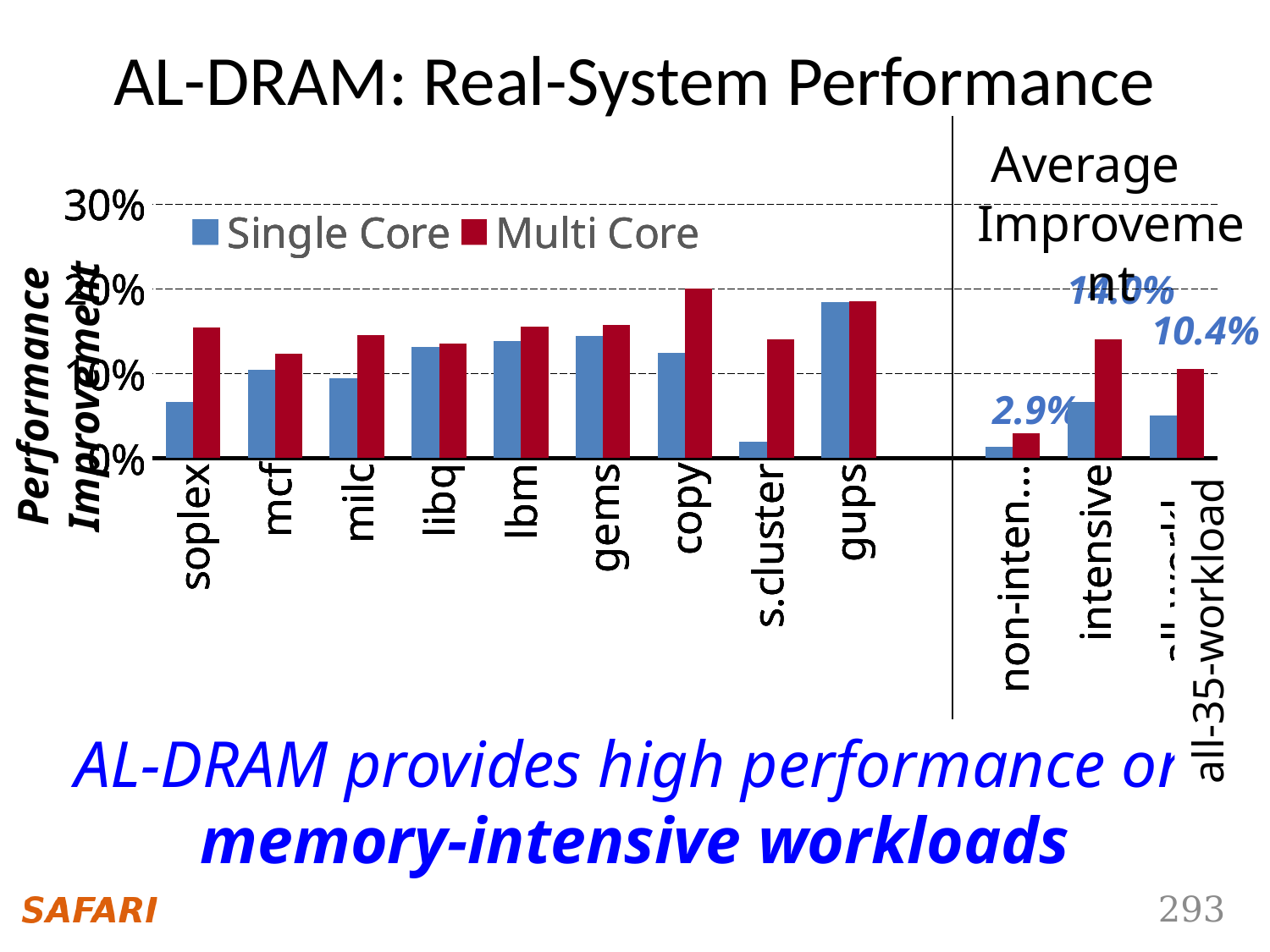
What kind of chart is shown on the slide? bar chart What is the labelled average Multi Core improvement for the intensive workloads? 14.0% Which benchmark has the highest Single Core performance improvement? gups Which benchmark has the highest Multi Core performance improvement? copy How many bar groups (categories) are plotted along the x axis? 12 Is the Single Core value for soplex greater or less than 10%? less How many series does the legend list? 2 Among the nine individual benchmarks left of the divider, which has the lowest Single Core performance improvement? s.cluster Is the Multi Core value for copy greater or less than 10%? greater What are the two series named in the legend? Single Core and Multi Core For s.cluster, which is larger: the Single Core or the Multi Core improvement? Multi Core What is the labelled average Multi Core improvement for all-35-workload? 10.4%